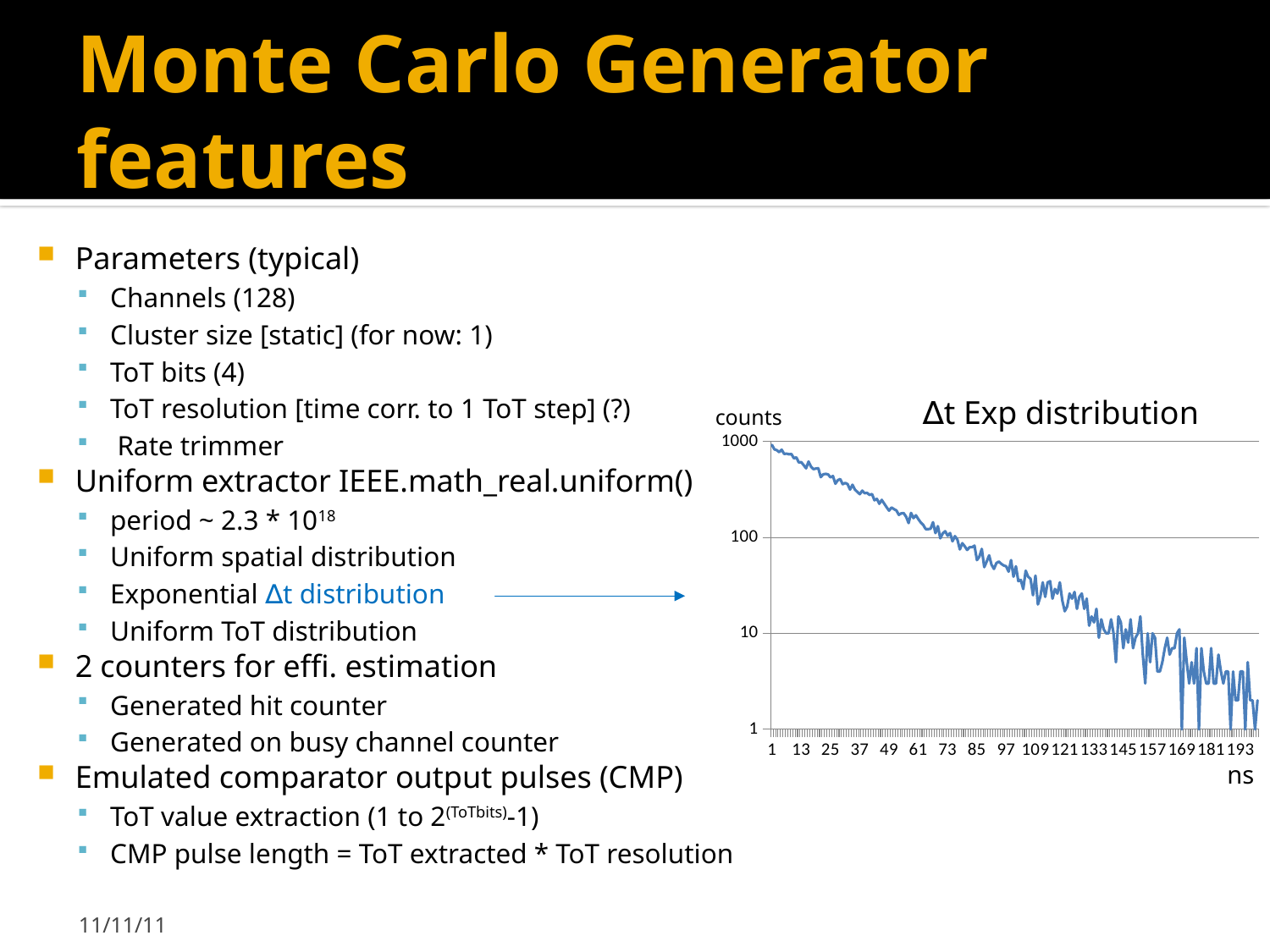
What unit label is shown on the x axis of the chart? ns In the Δt Exp distribution chart, is the value at x = 193 greater or less than 10? less What is the highest tick value shown on the y axis of the chart? 1000 Do the values in the Δt Exp distribution chart rise or fall as the x axis increases? fall What kind of chart is shown on the slide? line chart What is the lowest tick value shown on the y axis of the chart? 1 What is the title of the chart? Δt Exp distribution In the Δt Exp distribution chart, is the value at x = 97 greater or less than 100? less Which is larger in the Δt Exp distribution chart, the value at x = 1 or the value at x = 193? x = 1 How many tick labels are printed along the x axis of the chart? 17 In the Δt Exp distribution chart, is the value at x = 1 greater or less than 100? greater